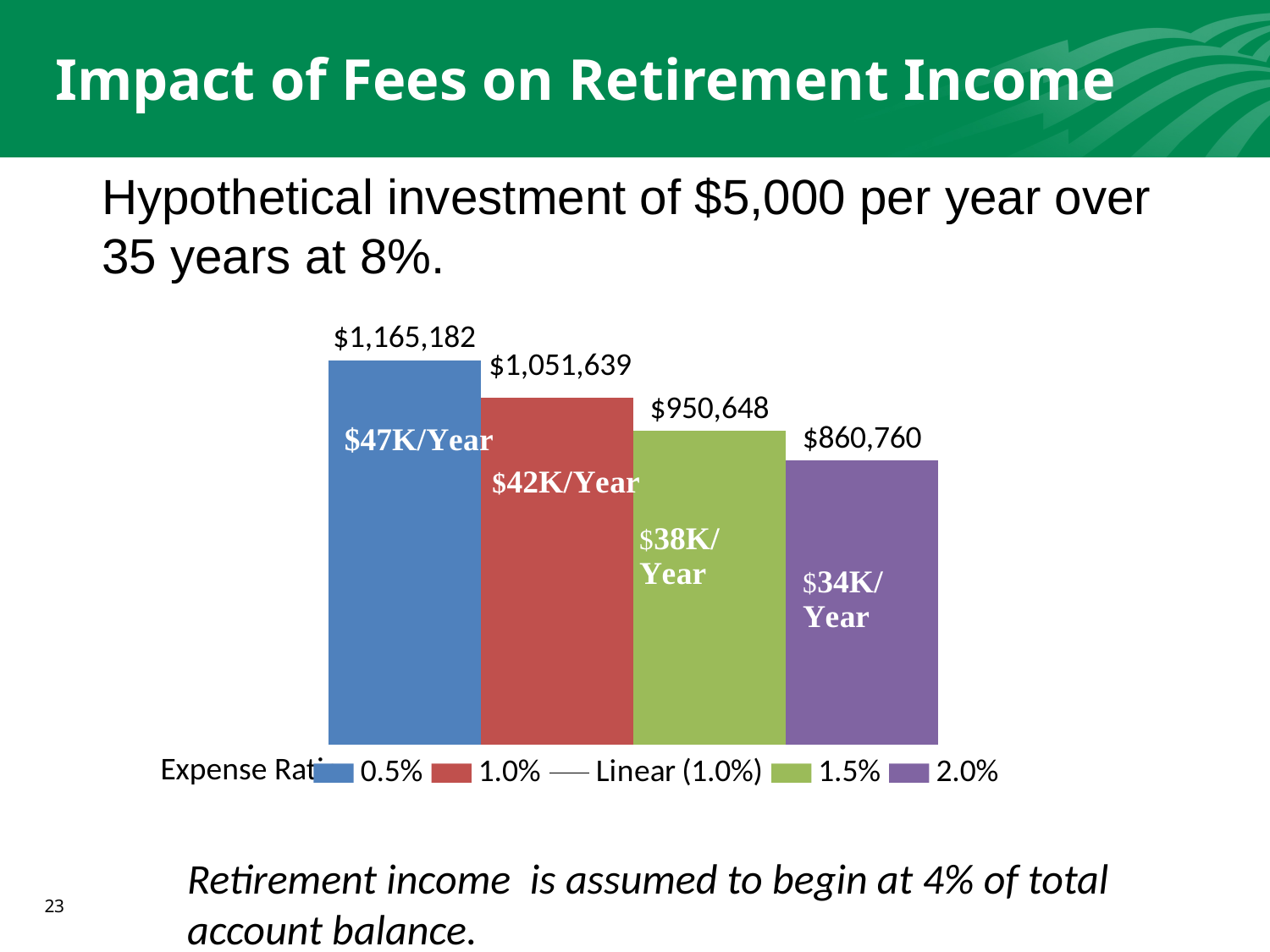
What kind of chart is shown on the slide? Bar chart How many entries does the chart legend list? 5 What is the difference in account balance between the 0.5% and 2.0% expense ratios? $304,422 What is the account balance shown for the 1.5% expense ratio? $950,648 What annual retirement income is shown on the bar for the 1.0% expense ratio? $42K/Year How many bars are plotted in the chart? 4 Which expense ratio has the highest account balance? 0.5% Which has a larger account balance, the 1.0% or the 1.5% expense ratio? 1.0% What is the account balance shown for the 2.0% expense ratio? $860,760 Which expense ratio has the lowest account balance? 2.0% What is the account balance shown for the 0.5% expense ratio? $1,165,182 What is the difference in account balance between the 0.5% and 1.0% expense ratios? $113,543